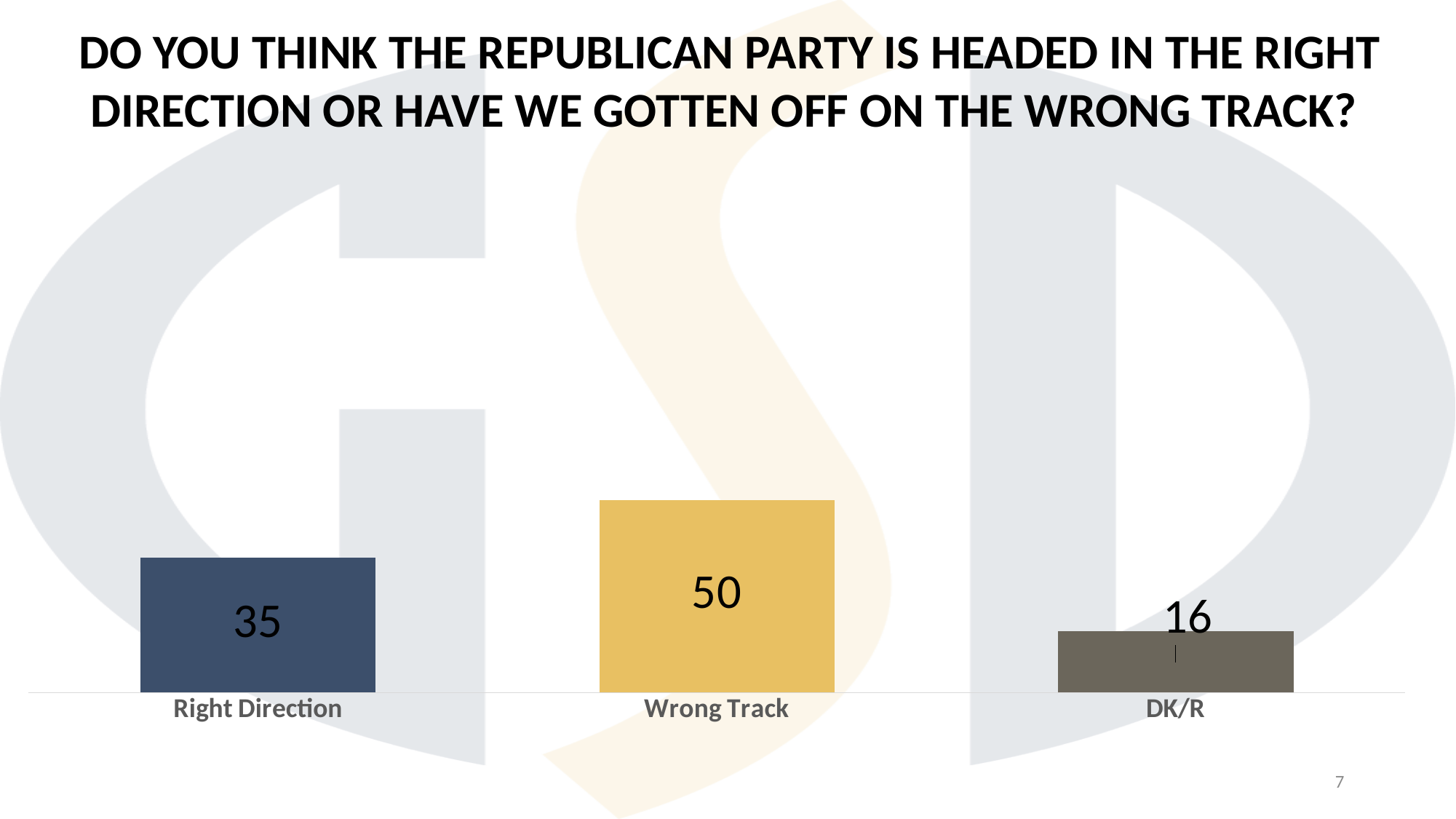
Which category has the lowest value? DK/R What is the value for Right Direction? 35 What is the difference between the values for Right Direction and DK/R? 19 What colour is the bar for Wrong Track? yellow What is the title of the chart? Do you think the Republican Party is headed in the right direction or have we gotten off on the wrong track? How many categories are shown in the chart? 3 Which is larger, the value for Right Direction or the value for Wrong Track? Wrong Track What is the difference between the values for Wrong Track and Right Direction? 15 What is the value for Wrong Track? 50 Which category has the highest value? Wrong Track What is the value for DK/R? 16 What kind of chart is shown on the slide? bar chart